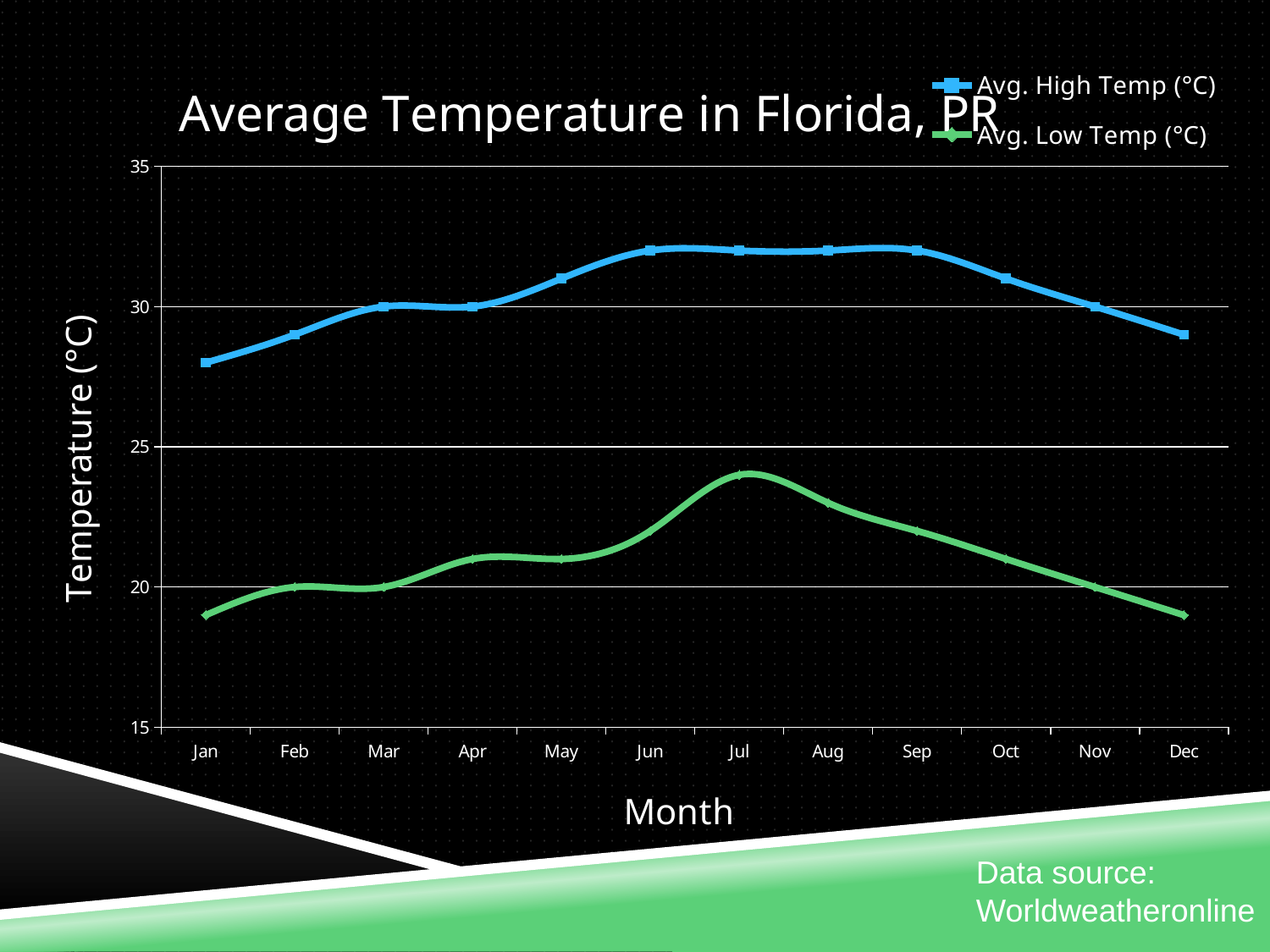
Is the Avg. High Temp value for Jun greater or less than 30? greater What kind of chart is shown on the slide? line chart What is the Avg. High Temp (°C) for Mar? 30 Does the Avg. High Temp rise or fall from Jan to Jun? rise Is the Avg. Low Temp value for Jul greater or less than 25? less Which month has the highest Avg. Low Temp? Jul What is the Avg. High Temp (°C) for Nov? 30 How many months are plotted along the x axis? 12 Is the Avg. High Temp value for Jan greater or less than 30? less What is the Avg. Low Temp (°C) for Feb? 20 How many series does the legend list? 2 What is the title of the chart? Average Temperature in Florida, PR